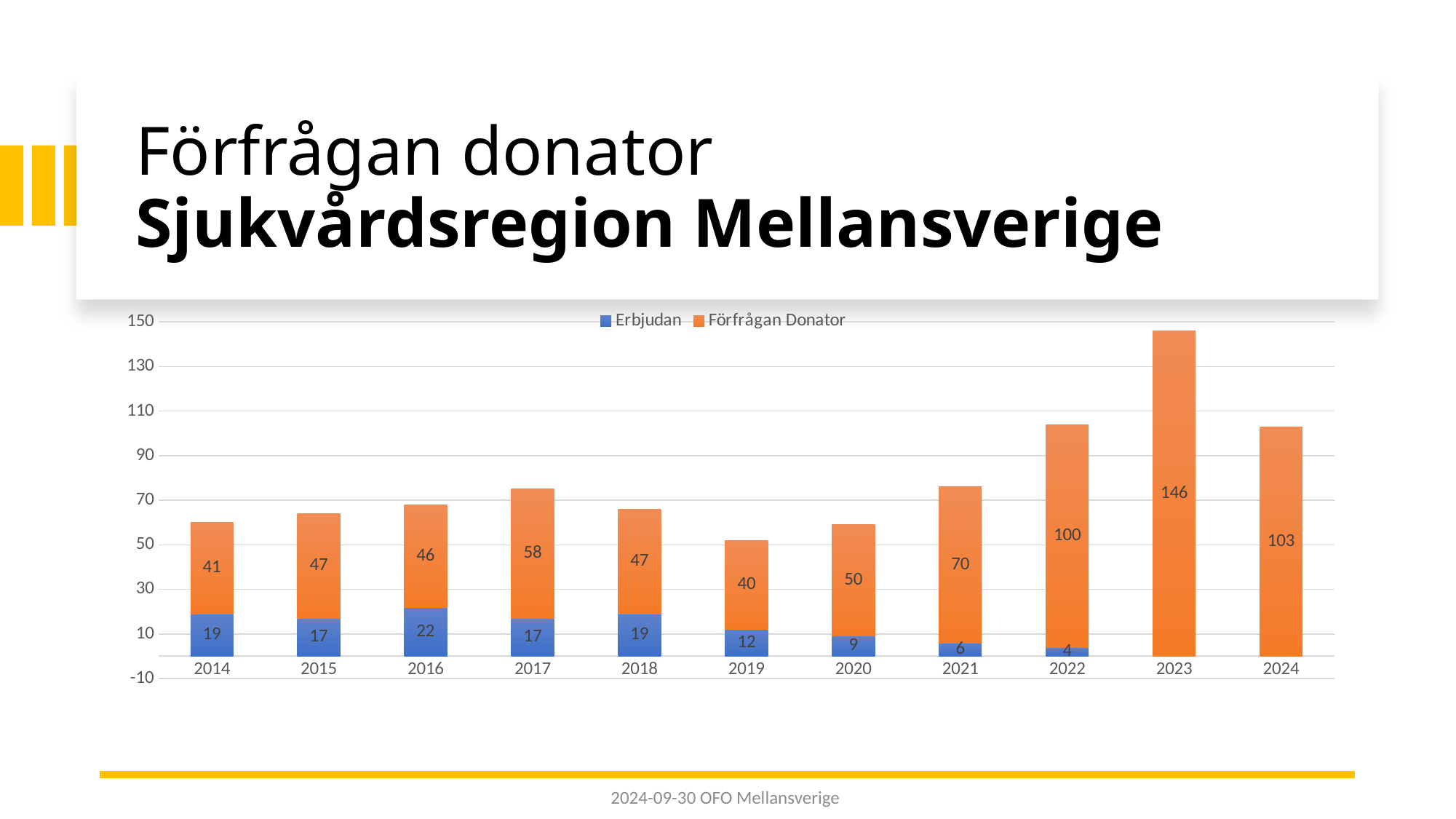
How many series does the legend list? 2 Is the total stacked bar for 2022 greater or less than 90? greater Which year has the highest Förfrågan Donator value? 2023 What is the total of the stacked bar for 2014? 60 What is the difference between the Förfrågan Donator values for 2023 and 2024? 43 How many years are shown on the x axis? 11 Which is larger, the Erbjudan value for 2014 or for 2019? 2014 What kind of chart is shown on the slide? Stacked bar chart What is the Erbjudan value for 2016? 22 What is the Förfrågan Donator value for 2017? 58 Which series is shown in orange in the legend? Förfrågan Donator Which year has the lowest Förfrågan Donator value? 2019